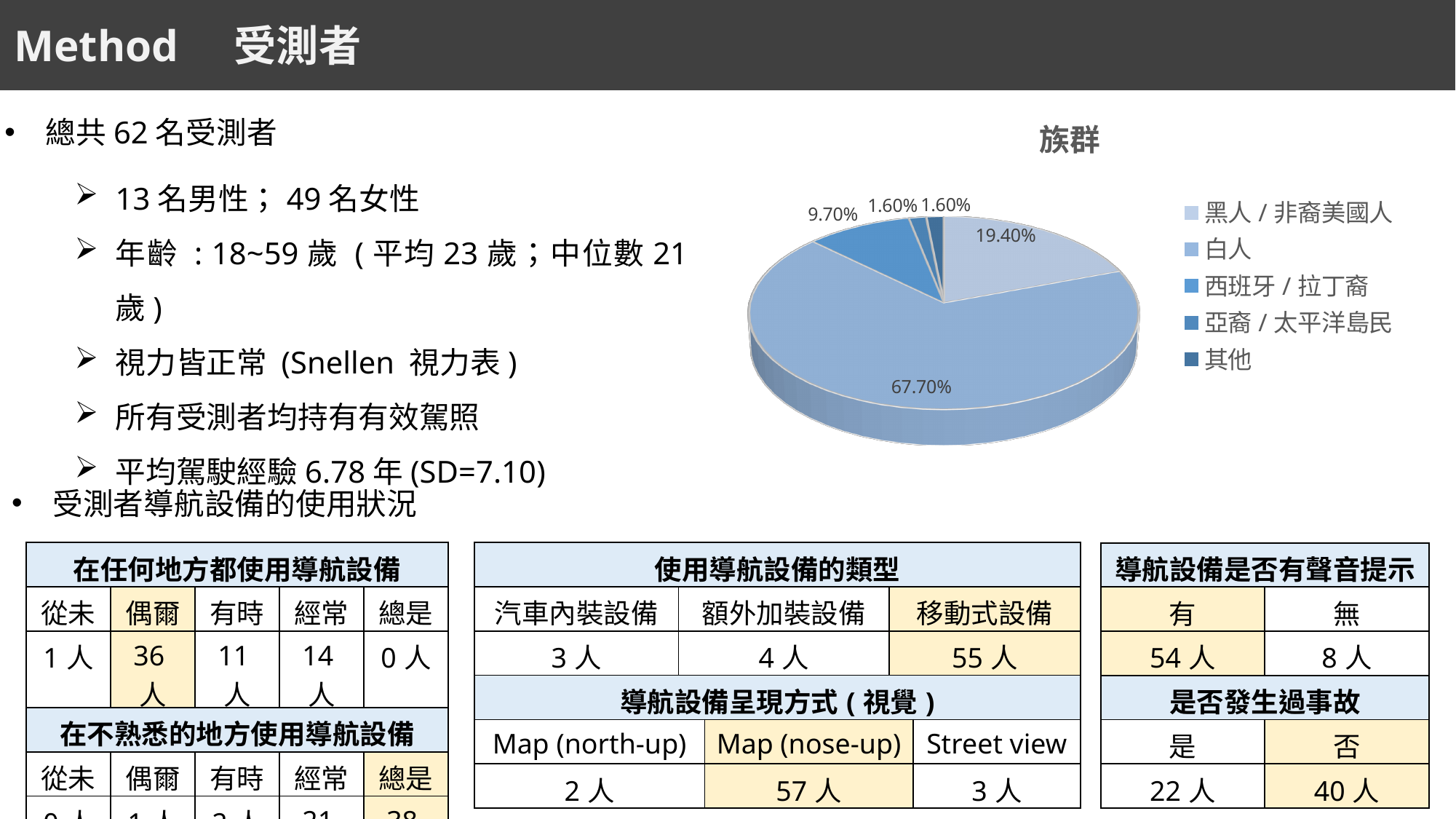
Which category has the largest share of the pie chart? 白人 How many slices does the pie chart have? 5 What percentage of the pie chart is 黑人 / 非裔美國人? 19.40% Which is larger in the pie chart, 黑人 / 非裔美國人 or 西班牙 / 拉丁裔? 黑人 / 非裔美國人 What percentage of the pie chart is 白人? 67.70% What percentage of the pie chart is 西班牙 / 拉丁裔? 9.70% What percentage of the pie chart is 亞裔 / 太平洋島民? 1.60% How many entries does the legend of the pie chart list? 5 What is the difference in percentage points between 白人 and 黑人 / 非裔美國人 in the pie chart? 48.30% What kind of chart is shown on the slide? Pie chart What is the title of the pie chart? 族群 What is the combined share of 亞裔 / 太平洋島民 and 其他 in the pie chart? 3.20%